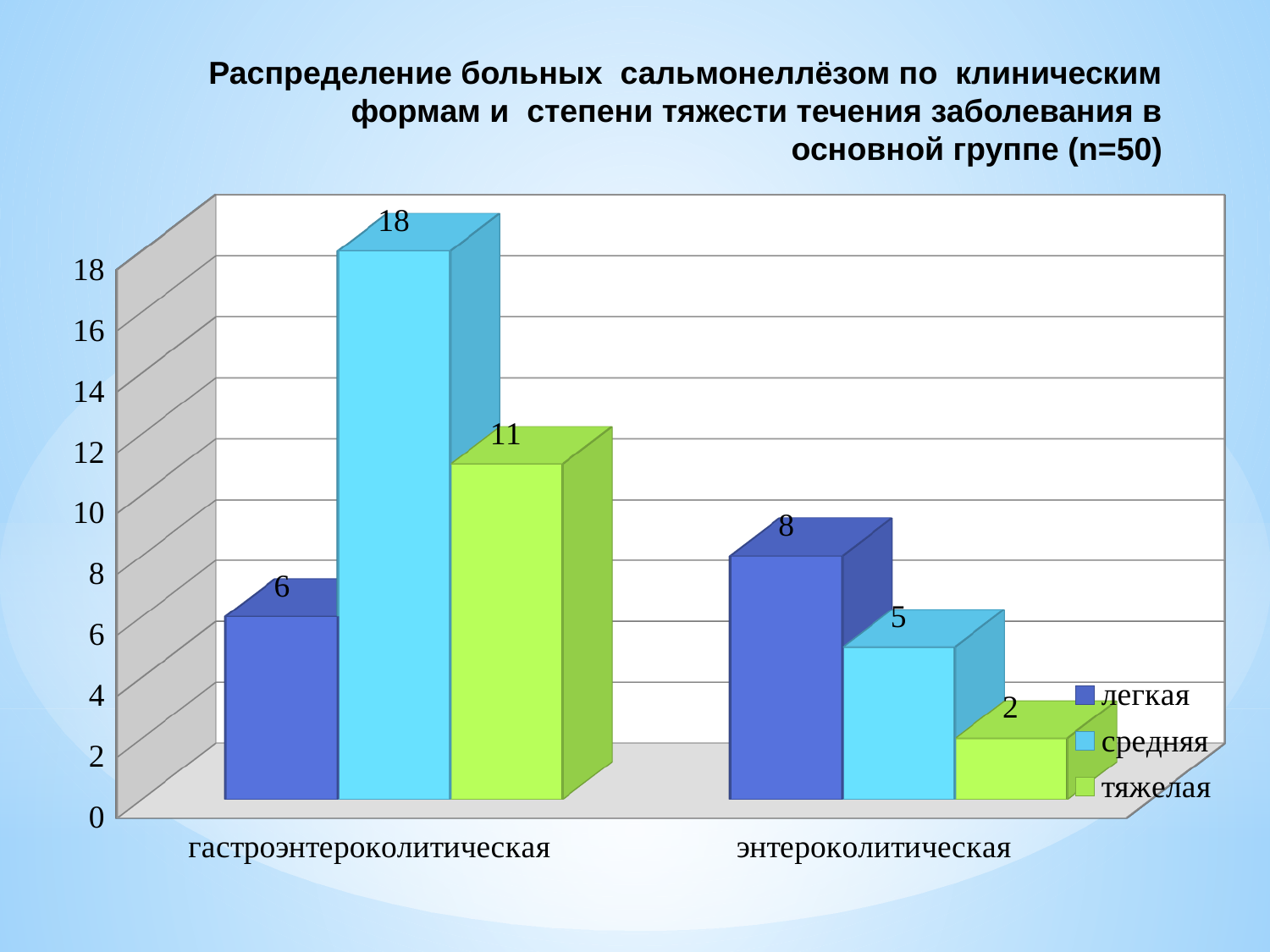
What is the value for легкая in the энтероколитическая category? 8 How many categories are shown on the x axis? 2 What is the total of all three series for the гастроэнтероколитическая category? 35 Which is larger: легкая for гастроэнтероколитическая or легкая for энтероколитическая? энтероколитическая How many series does the legend list? 3 What is the value for тяжелая in the энтероколитическая category? 2 What is the value for средняя in the гастроэнтероколитическая category? 18 Which series has the lowest value in the энтероколитическая category? тяжелая What kind of chart is shown on the slide? bar chart Which series has the highest value in the гастроэнтероколитическая category? средняя Which colour represents the тяжелая series? green What is the difference between the средняя values for гастроэнтероколитическая and энтероколитическая? 13